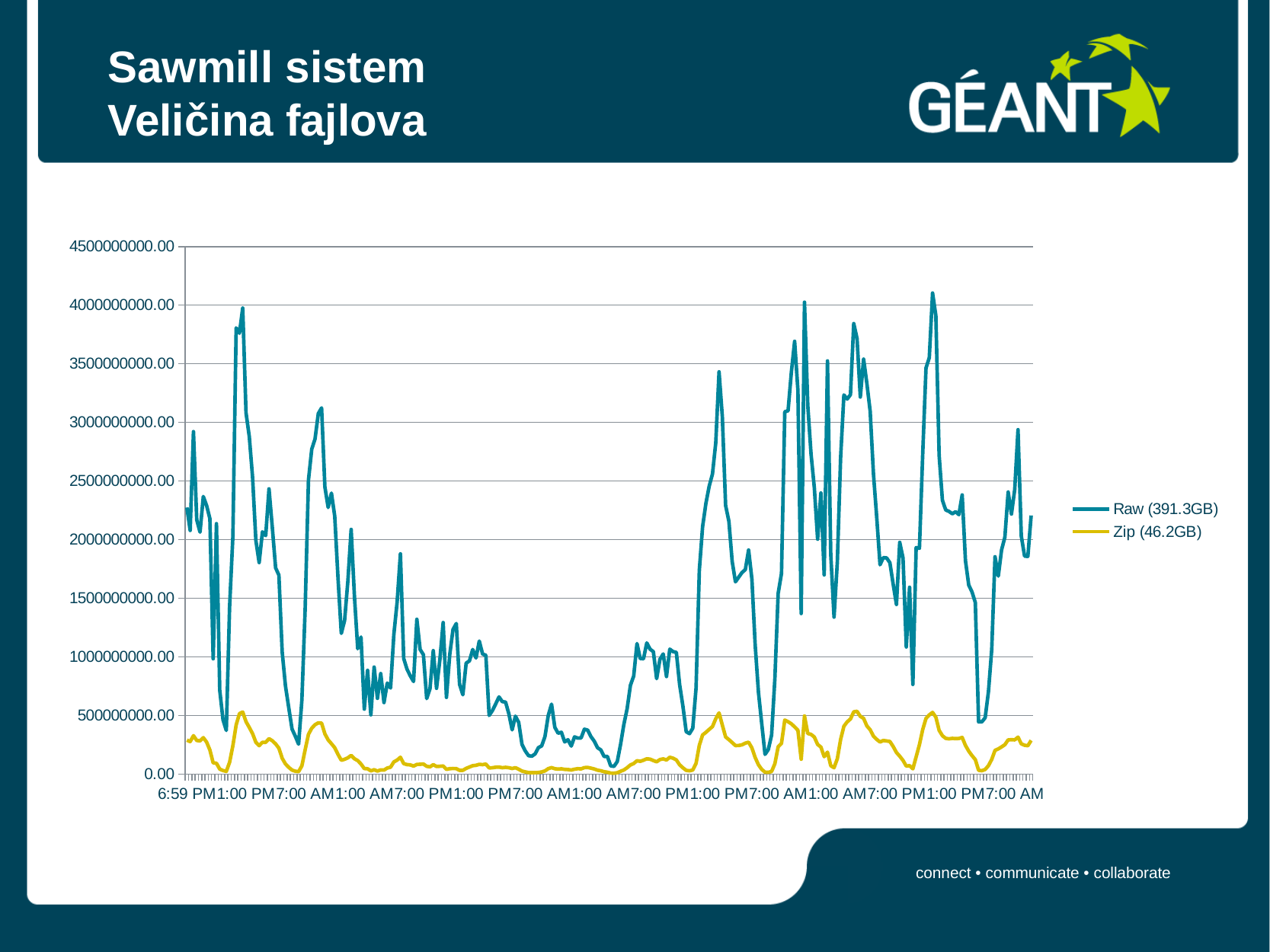
What total size is shown in the legend for the Raw series? 391.3GB Which series has the larger total size according to the legend, Raw or Zip? Raw What is the first time label on the horizontal axis? 6:59 PM Is the highest value of the Zip series greater or less than 1000000000.00? less What is the difference between the Raw and Zip totals shown in the legend? 345.1GB What kind of chart is shown on the slide? line chart Which series stays lower across the whole chart, Raw or Zip? Zip Is the highest value of the Raw series greater or less than 3500000000.00? greater What total size is shown in the legend for the Zip series? 46.2GB What is the highest value labelled on the vertical axis? 4500000000.00 What are the two series named in the legend? Raw (391.3GB) and Zip (46.2GB) How many series does the legend list? 2